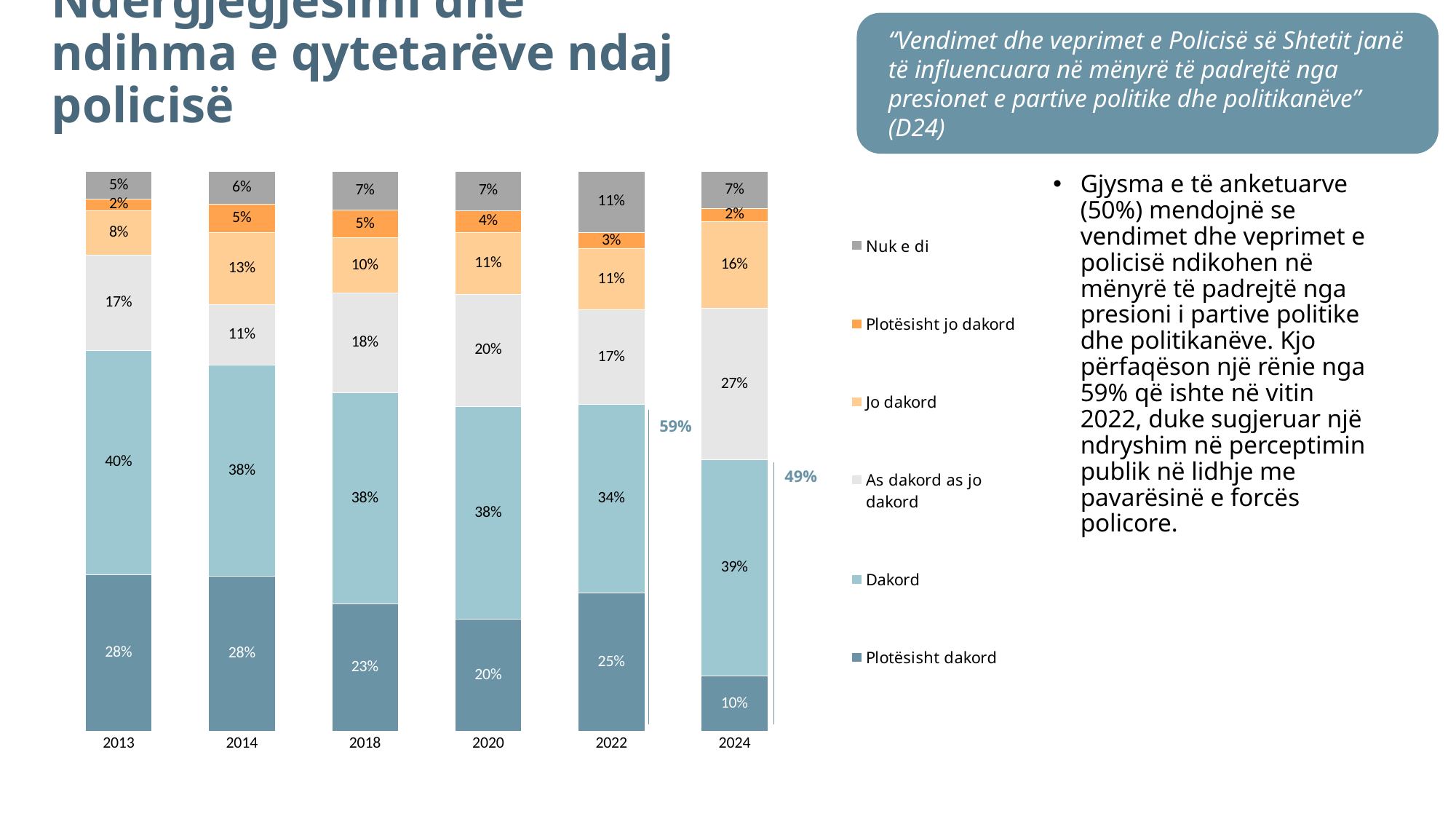
What kind of chart is shown on the slide? Stacked bar chart How many series does the legend list? 6 How many years are shown on the x axis? 6 What is the combined total of "Plotësisht dakord" and "Dakord" in 2022, as annotated next to the bar? 59% What is the value for "Dakord" in 2013? 40% In which year is the "Plotësisht dakord" value lowest? 2024 In which year is the "As dakord as jo dakord" value highest? 2024 What is the value for "Nuk e di" in 2022? 11% What is the value for "As dakord as jo dakord" in 2024? 27% What is the difference between the "Plotësisht dakord" values for 2022 and 2024? 15% What is the value for "Plotësisht dakord" in 2024? 10% Which is larger, the "Jo dakord" value in 2014 or in 2018? 2014